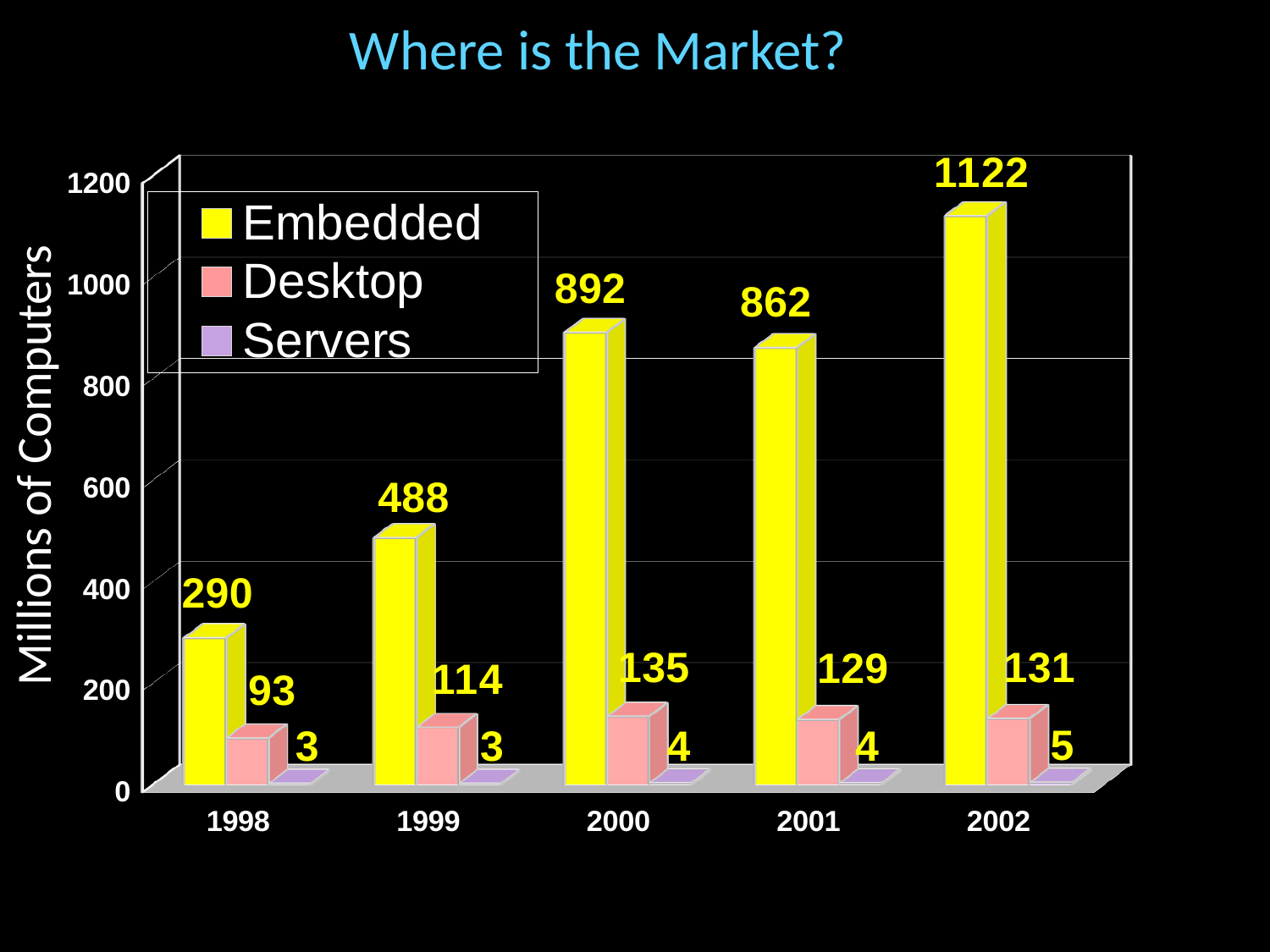
How many years are shown on the x axis? 5 What kind of chart is shown on the slide? bar chart How many series does the legend list? 3 What is the label of the y axis? Millions of Computers Is the Embedded value for 1999 greater or less than 400? greater In which year is the Desktop value lowest? 1998 What is the Embedded value for 2002? 1122 What is the Desktop value for 1999? 114 What is the Servers value for 2002? 5 What is the difference between the Embedded values for 2002 and 2001? 260 In which year is the Embedded value highest? 2002 Which is larger, the Embedded value for 2000 or for 2001? 2000